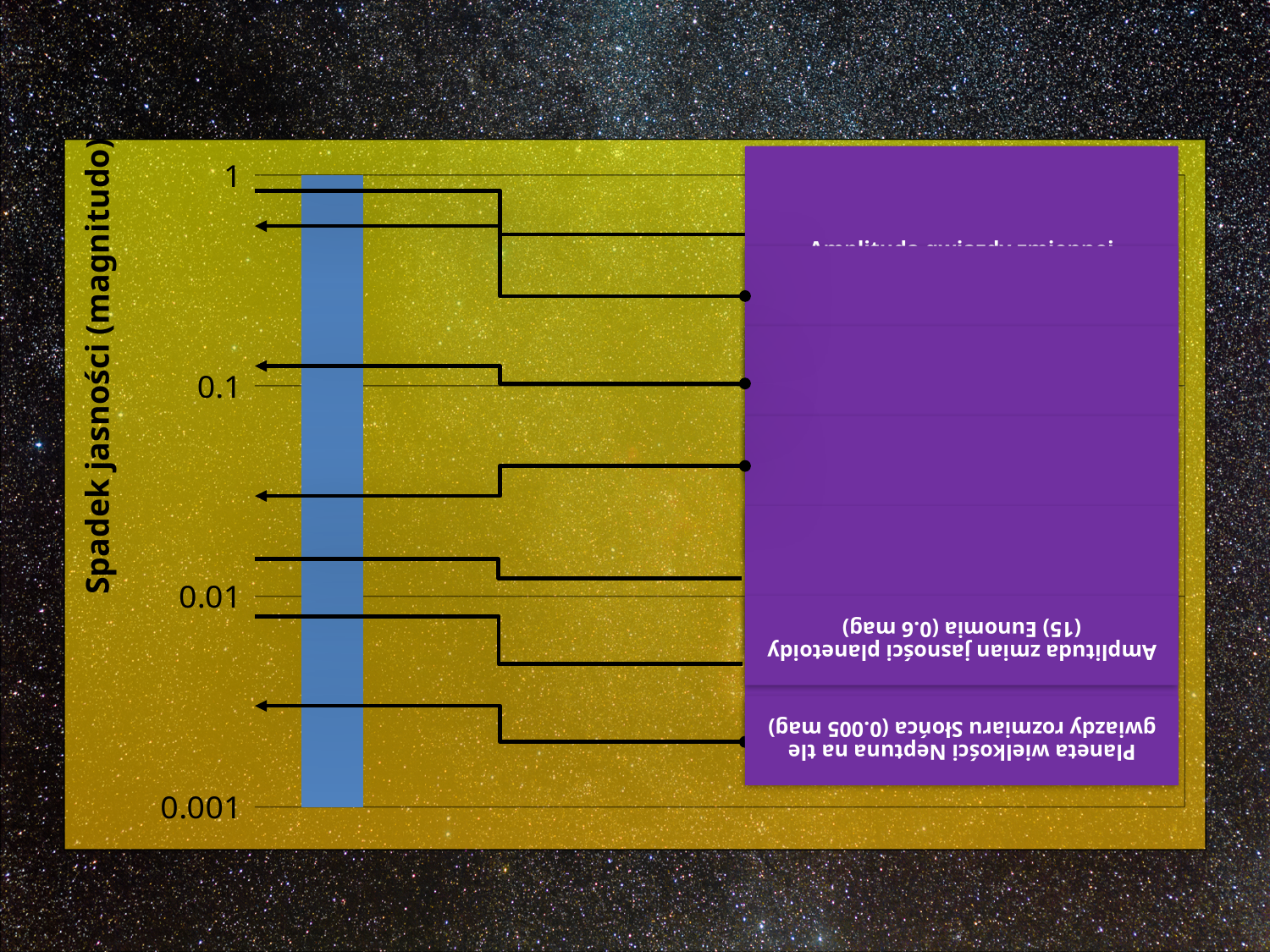
What kind of chart is shown on the slide? Bar chart What brightness amplitude is given on the slide for the planetoid (15) Eunomia? 0.6 mag How many tick labels are shown on the vertical axis of the chart? 4 What brightness drop is given on the slide for a Neptune-sized planet in front of a Sun-sized star? 0.005 mag By what factor do consecutive tick labels on the vertical axis differ? 10 What is the label of the vertical axis of the chart? Spadek jasności (magnitudo) What is the lowest tick value printed on the vertical axis? 0.001 What is the highest tick value printed on the vertical axis? 1 Which is larger: the amplitude for planetoid (15) Eunomia or the drop for a Neptune-sized planet? Planetoid (15) Eunomia Is the amplitude given for planetoid (15) Eunomia greater or less than 0.1? greater Is the brightness drop given for a Neptune-sized planet greater or less than 0.01? less